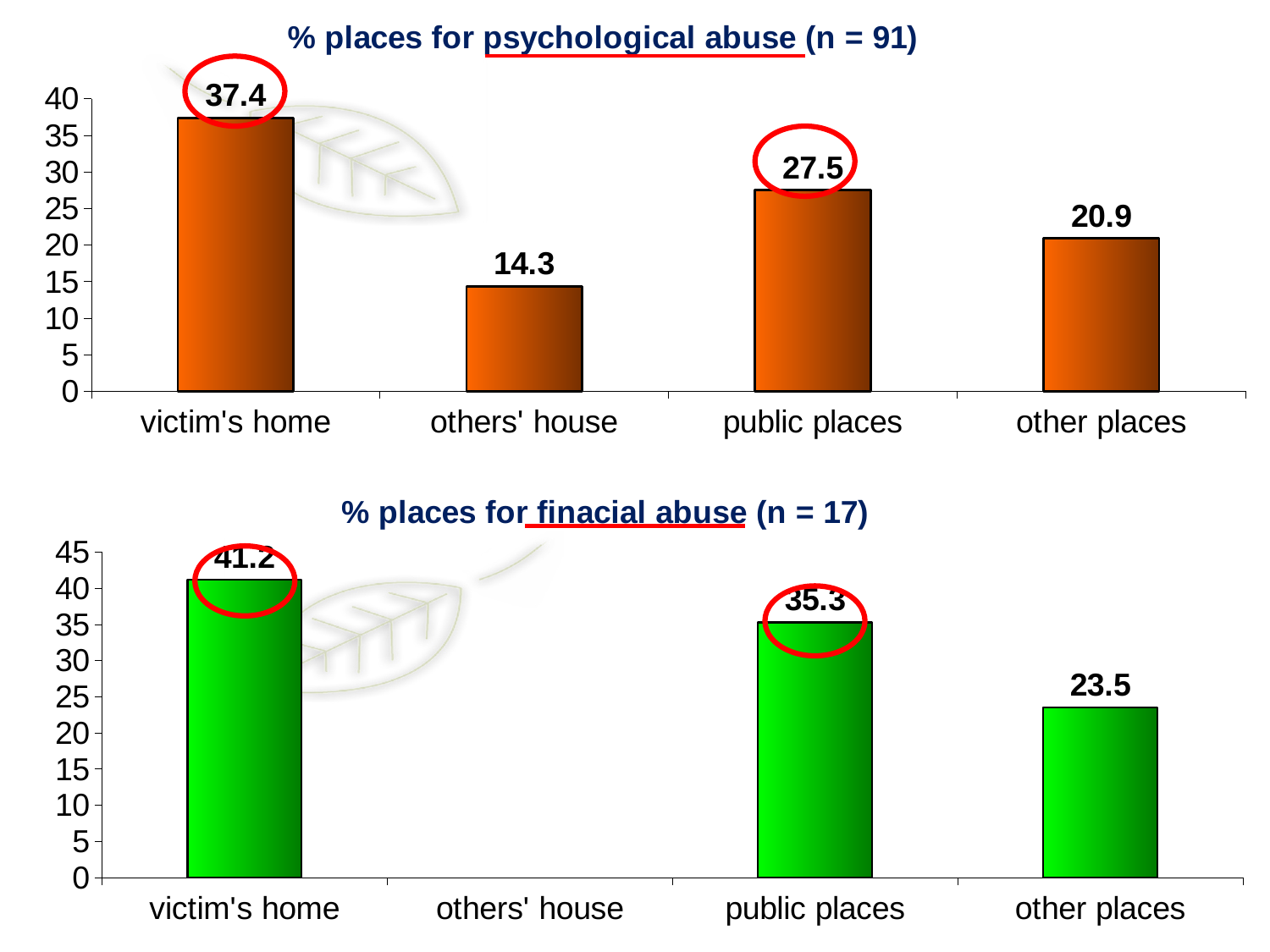
In the top chart (% places for psychological abuse), what is the value for others' house? 14.3 In the top chart (% places for psychological abuse), what is the difference between victim's home and public places? 9.9 What kind of chart is the bottom chart (% places for finacial abuse)? bar chart In the top chart (% places for psychological abuse), how many categories are shown on the x axis? 4 In the bottom chart (% places for finacial abuse), is the value for other places greater or less than 25? less In the bottom chart (% places for finacial abuse), what is the difference between victim's home and other places? 17.7 In the top chart (% places for psychological abuse), what is the value for victim's home? 37.4 In the top chart (% places for psychological abuse), which is larger: public places or other places? public places In the bottom chart (% places for finacial abuse), which category has the highest value? victim's home What sample size (n) is given in the title of the top chart? n = 91 In the top chart (% places for psychological abuse), which category has the lowest value? others' house In the bottom chart (% places for finacial abuse), what is the value for public places? 35.3